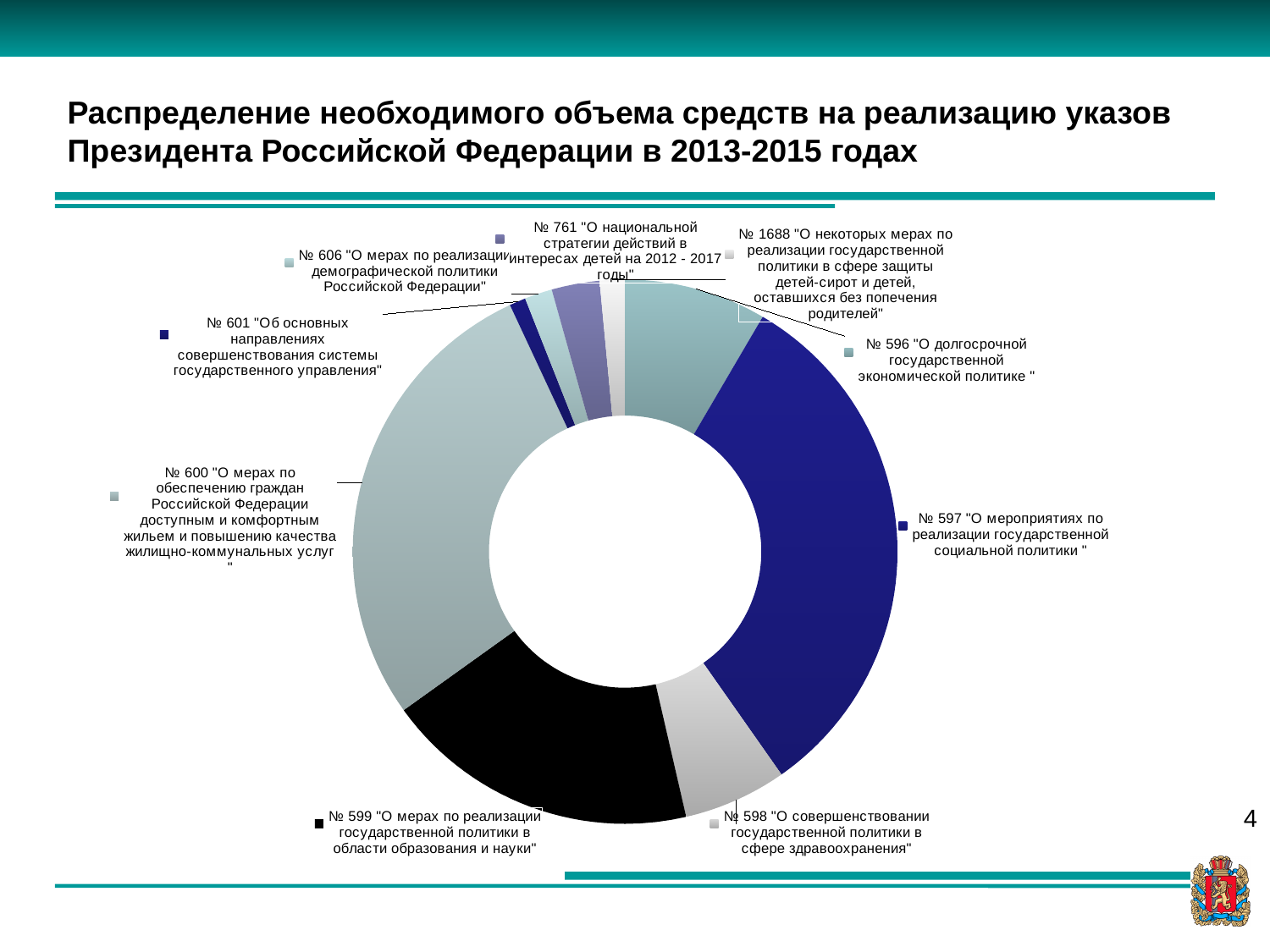
Which slice is larger: № 596 (long-term economic policy) or № 761 (national strategy for children)? № 596 What colour is the slice for decree № 599 (education and science)? Black What is the title of the slide containing the chart? Распределение необходимого объема средств на реализацию указов Президента Российской Федерации в 2013-2015 годах What kind of chart is shown on the slide? Doughnut (pie) chart Which slice is larger: № 600 (housing and utilities) or № 601 (public administration)? № 600 Which slice is larger: № 599 (education and science) or № 606 (demographic policy)? № 599 How many decrees (categories) are shown in the chart? 9 Which decree has the largest share of the required funds in the chart? № 597 "О мероприятиях по реализации государственной социальной политики"